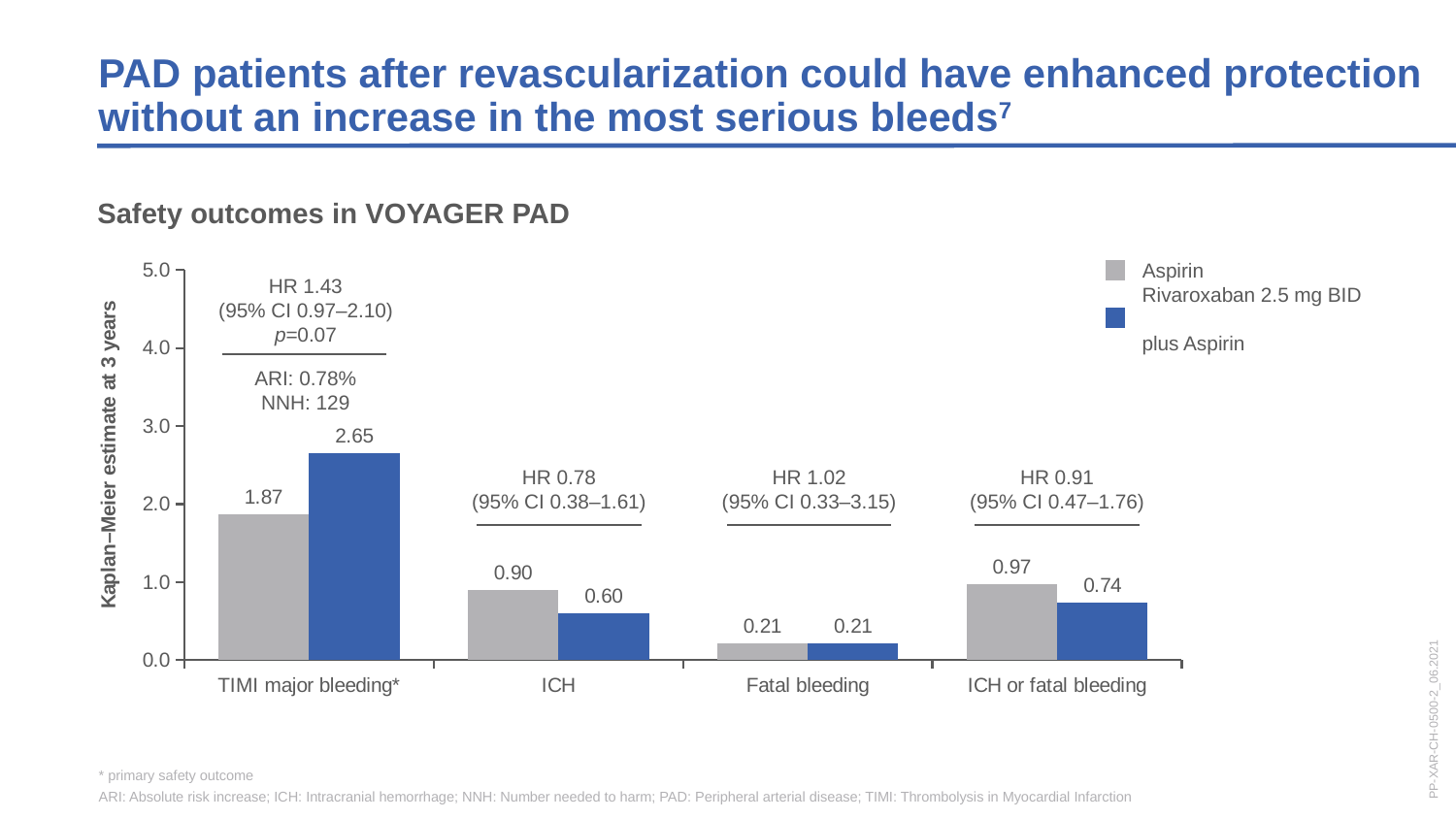
What is the Kaplan–Meier estimate for Aspirin for TIMI major bleeding*? 1.87 What is the Kaplan–Meier estimate for Rivaroxaban 2.5 mg BID plus Aspirin for TIMI major bleeding*? 2.65 What is the value for Rivaroxaban 2.5 mg BID plus Aspirin for ICH? 0.60 What is the difference between the Rivaroxaban 2.5 mg BID plus Aspirin and Aspirin values for TIMI major bleeding*? 0.78 What kind of chart is shown on the slide? Bar chart What is the hazard ratio shown above the Fatal bleeding bars? HR 1.02 Which category has the lowest value for the Rivaroxaban 2.5 mg BID plus Aspirin series? Fatal bleeding How many series does the legend list? 2 For ICH, which series has the larger value, Aspirin or Rivaroxaban 2.5 mg BID plus Aspirin? Aspirin How many categories are shown on the x axis? 4 Which category has the highest value for the Aspirin series? TIMI major bleeding* What is the value for Aspirin for ICH or fatal bleeding? 0.97